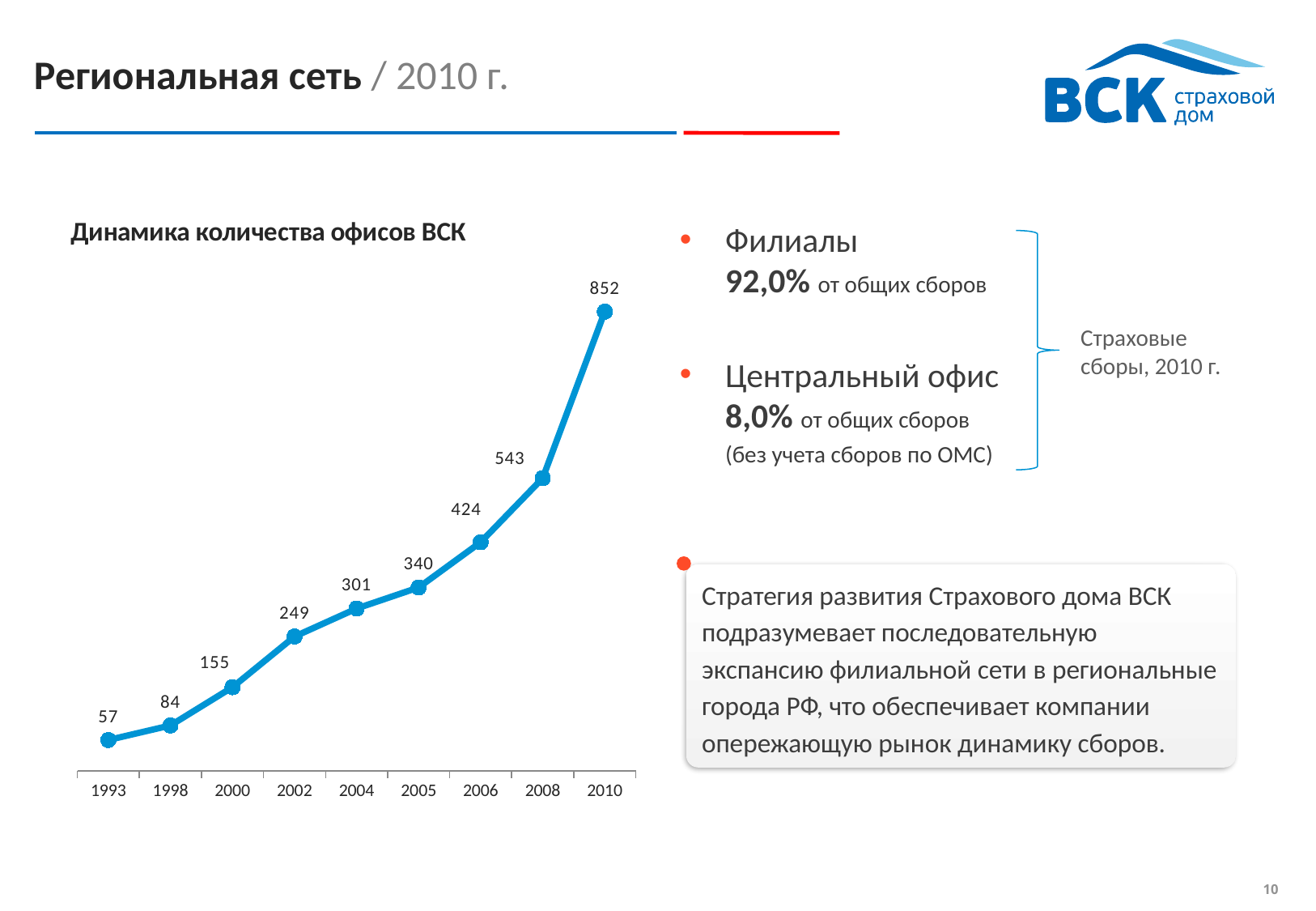
How many years are plotted on the chart? 9 What is the difference in the number of offices between 2000 and 2002? 94 By how much did the number of offices increase from 2008 to 2010? 309 What is the title of the chart? Динамика количества офисов ВСК Which year has the highest number of offices? 2010 Which year has the lowest number of offices? 1993 What is the number of VSK offices in 1993? 57 What is the number of VSK offices in 2010? 852 Which year has more offices, 2005 or 2006? 2006 Does the number of offices rise or fall from 1993 to 2010? Rise What is the number of VSK offices in 2004? 301 What type of chart is shown on the slide? Line chart